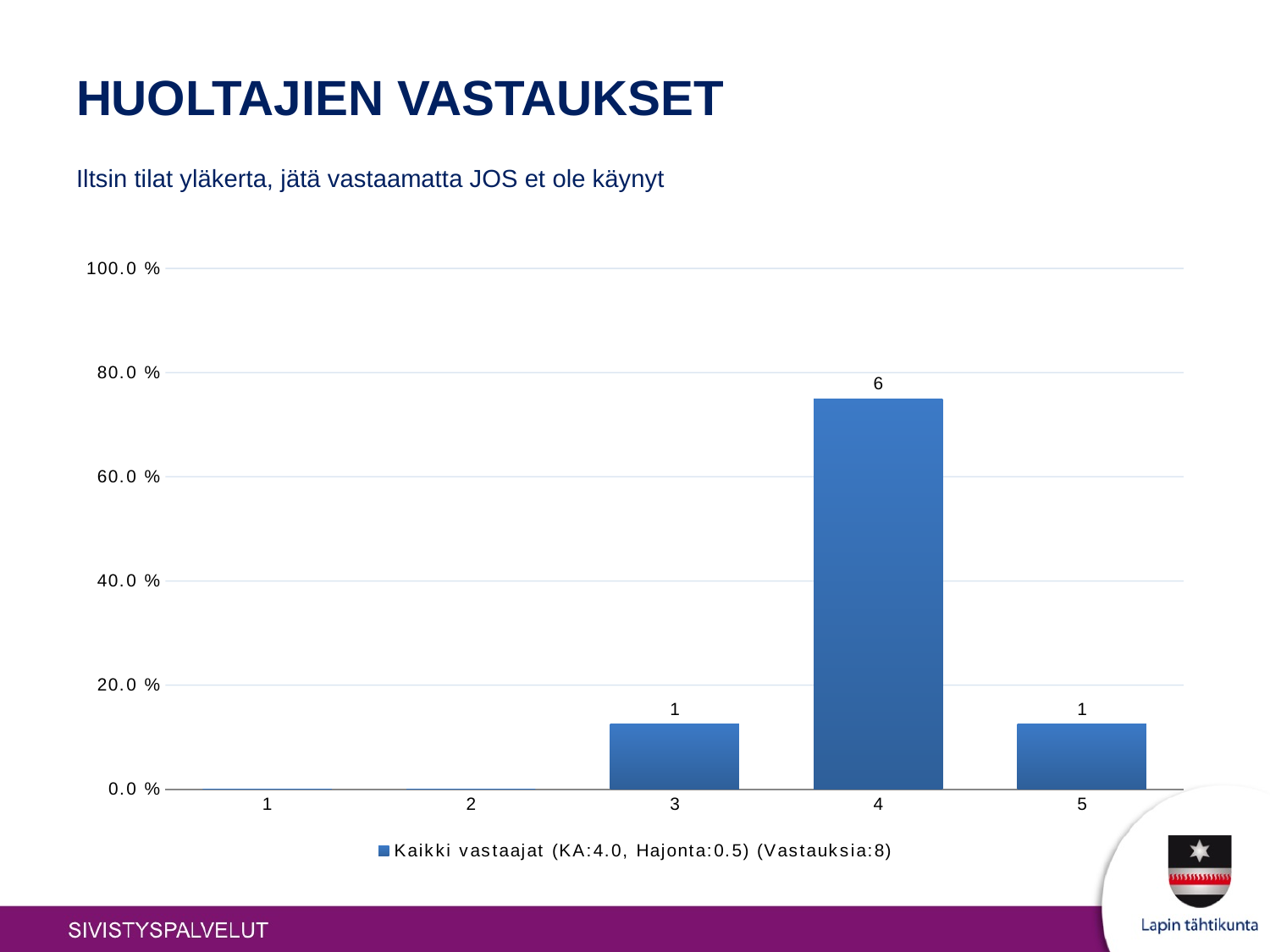
What is the difference between the data labels for category 4 and category 5? 5 Which category has the highest bar? 4 Is the bar for category 3 greater or less than 20.0 %? less What is the data label on the bar for category 5? 1 What is the data label on the bar for category 4? 6 What is the data label on the bar for category 3? 1 What is the legend entry for the series? Kaikki vastaajat (KA:4.0, Hajonta:0.5) (Vastauksia:8) Which bar is taller, category 4 or category 5? 4 What kind of chart is shown on the slide? bar chart Is the bar for category 4 greater or less than 60.0 %? greater How many categories are shown on the x axis? 5 How many series does the legend list? 1